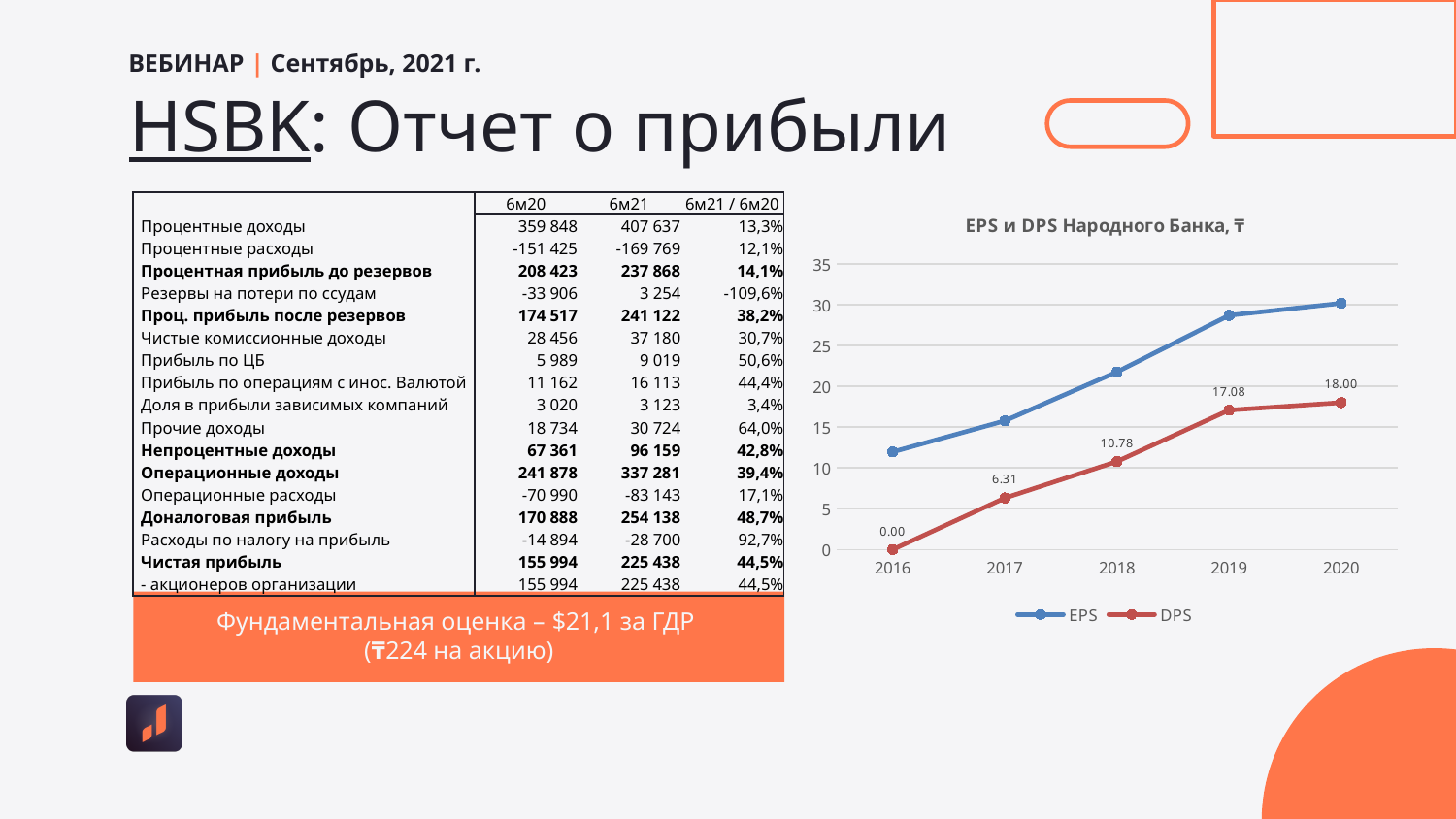
What is the DPS value for 2019? 17.08 Is the EPS value for 2016 greater or less than 10? greater What is the DPS value for 2020? 18.00 In which year is DPS the lowest? 2016 How many series does the chart legend list? 2 By how much did DPS increase from 2018 to 2019? 6.30 What is the DPS value for 2017 in the EPS и DPS Народного Банка chart? 6.31 Which series has the larger value in 2018, EPS or DPS? EPS Is the EPS value for 2019 greater or less than 25? greater How many years are plotted on the x axis of the chart? 5 What type of chart is used to show EPS and DPS? Line chart In which year is DPS the highest? 2020